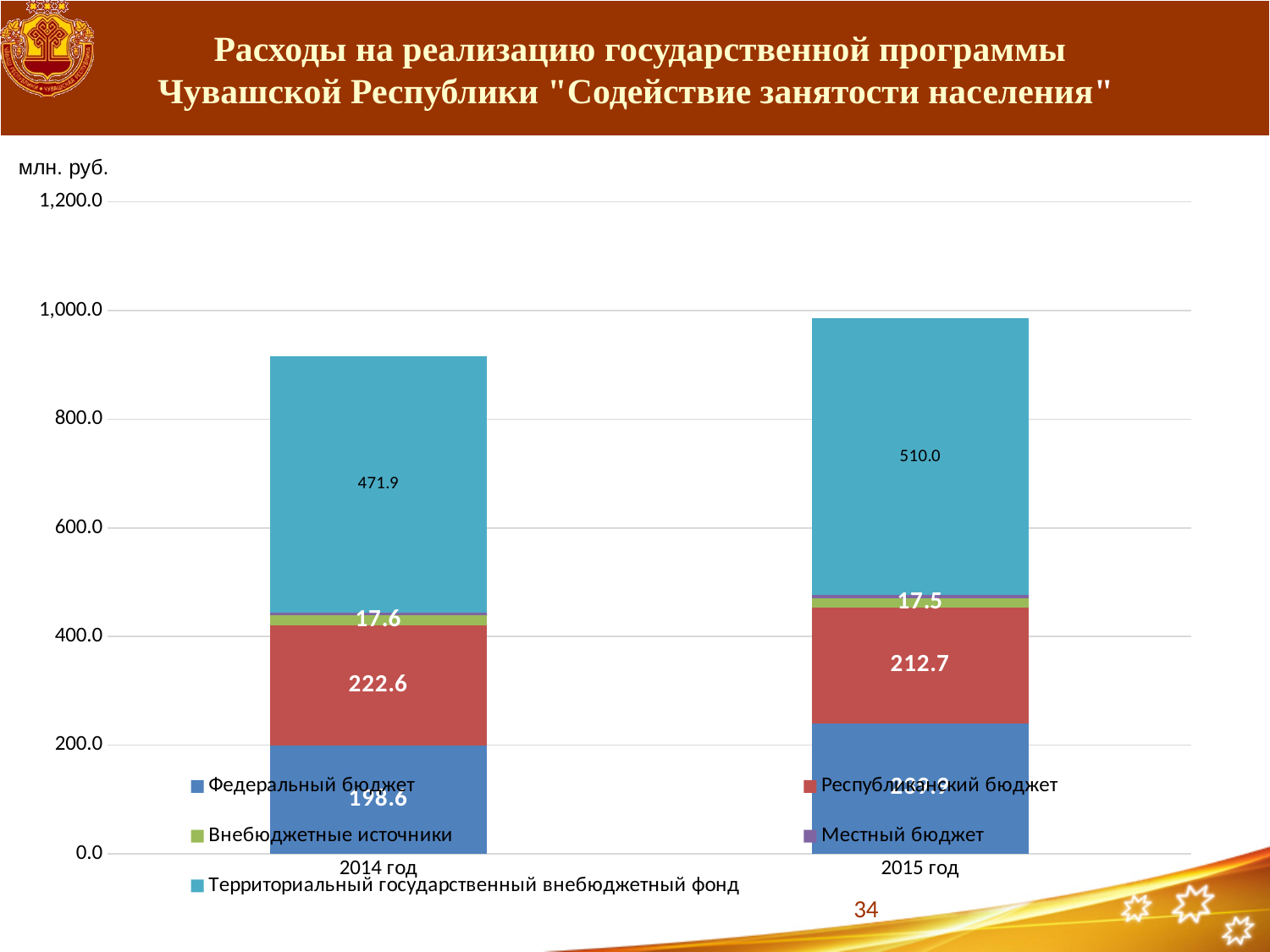
What kind of chart is shown on the slide? bar chart What is the value for Территориальный государственный внебюджетный фонд in 2014 год? 471.9 What is the value for Территориальный государственный внебюджетный фонд in 2015 год? 510.0 What is the value for Федеральный бюджет in 2014 год? 198.6 What is the value for Республиканский бюджет in 2015 год? 212.7 How many series does the legend list? 5 Which year has the larger value for Республиканский бюджет, 2014 год or 2015 год? 2014 год Is the total height of the 2015 год stacked bar greater or less than 800.0? greater By how much did the value for Территориальный государственный внебюджетный фонд increase from 2014 год to 2015 год? 38.1 What is the value for Внебюджетные источники in 2015 год? 17.5 How many year categories are shown on the x axis? 2 What is the value for Республиканский бюджет in 2014 год? 222.6